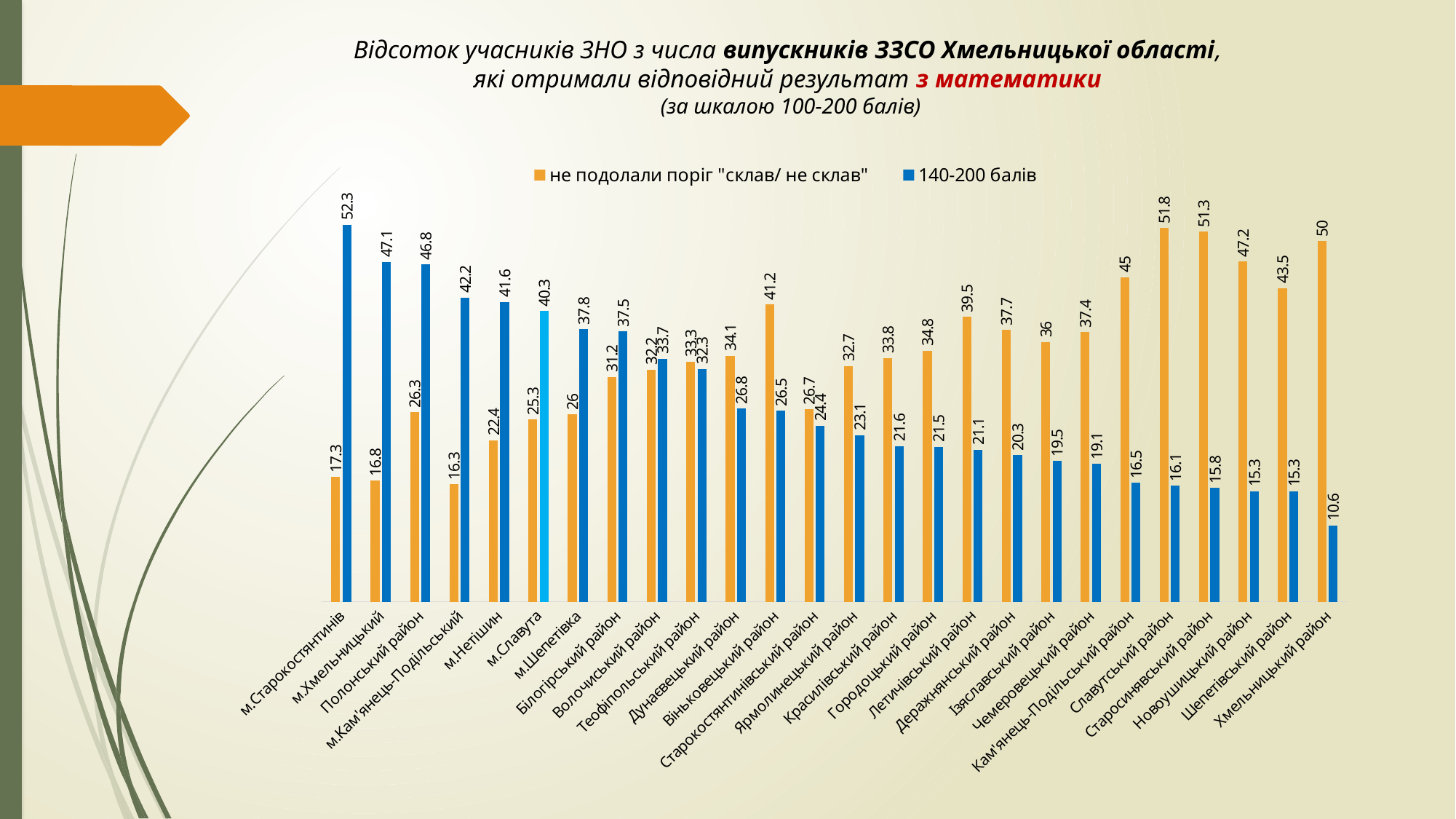
What is the value of 'не подолали поріг "склав/ не склав"' for Славутський район? 51.8 Which category has the lowest 'не подолали поріг "склав/ не склав"' value? м.Кам'янець-Подільський Which category has the lowest '140-200 балів' value? Хмельницький район For Віньковецький район, which series has the larger value: 'не подолали поріг' or '140-200 балів'? не подолали поріг "склав/ не склав" What kind of chart is shown on the slide? bar chart What percentage of participants from м.Старокостянтинів scored 140-200 балів? 52.3 What is the '140-200 балів' value for Хмельницький район? 10.6 How many series does the legend list? 2 What is the difference between the '140-200 балів' values for м.Хмельницький and Полонський район? 0.3 Do the '140-200 балів' values rise or fall from left to right along the x axis? fall How many categories are shown on the x axis? 26 Which category has the highest '140-200 балів' value? м.Старокостянтинів